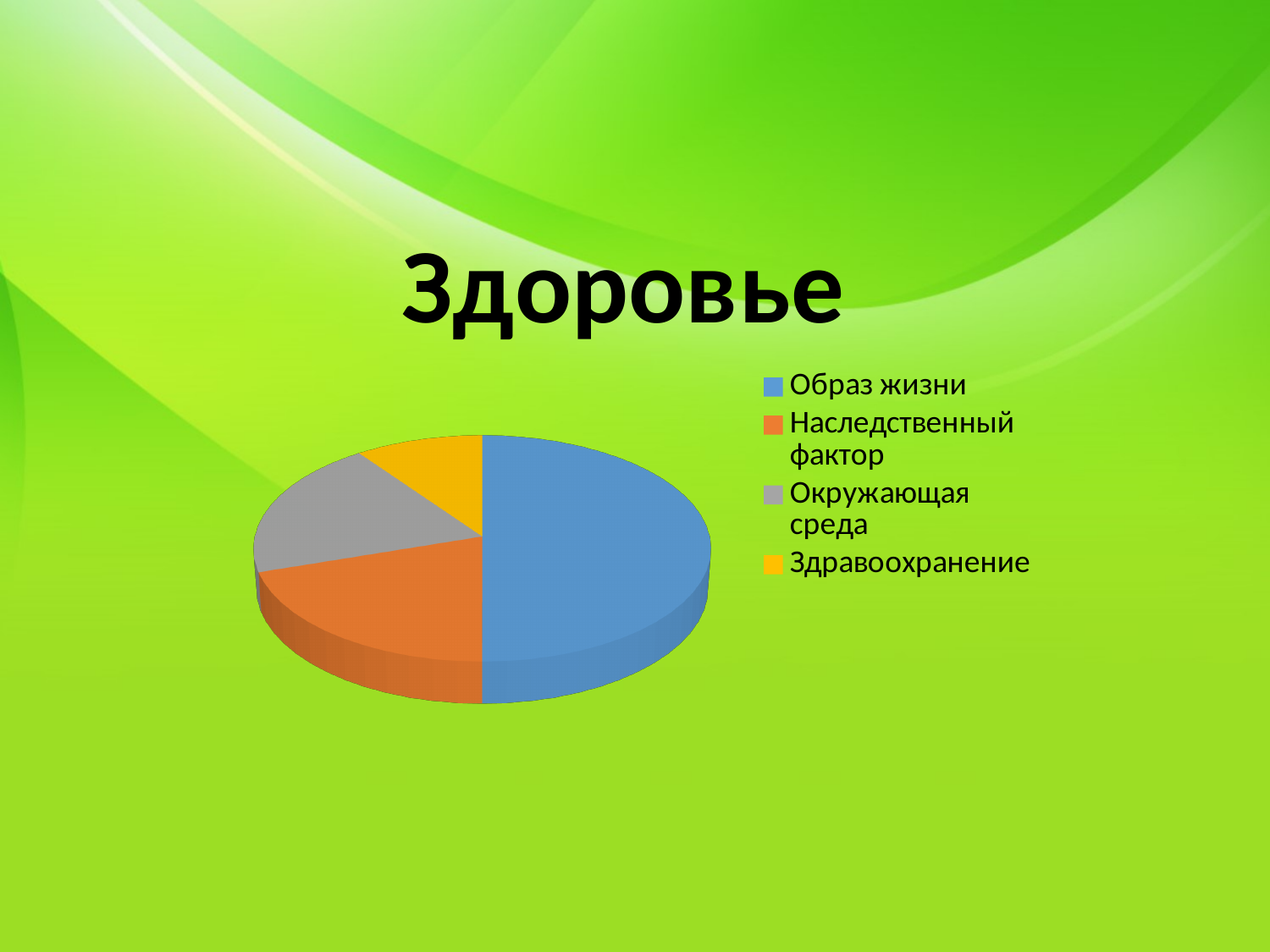
Which category has the smallest slice in the pie chart? Здравоохранение What kind of chart is shown on the slide? pie chart How many entries does the legend of the pie chart list? 4 Which slice is larger in the pie chart: Образ жизни or Наследственный фактор? Образ жизни How many slices does the pie chart have? 4 What colour is the slice for Образ жизни in the pie chart? blue Which category has the largest slice in the pie chart? Образ жизни Which slice is larger in the pie chart: Окружающая среда or Здравоохранение? Окружающая среда What is the title of the slide with the pie chart? Здоровье